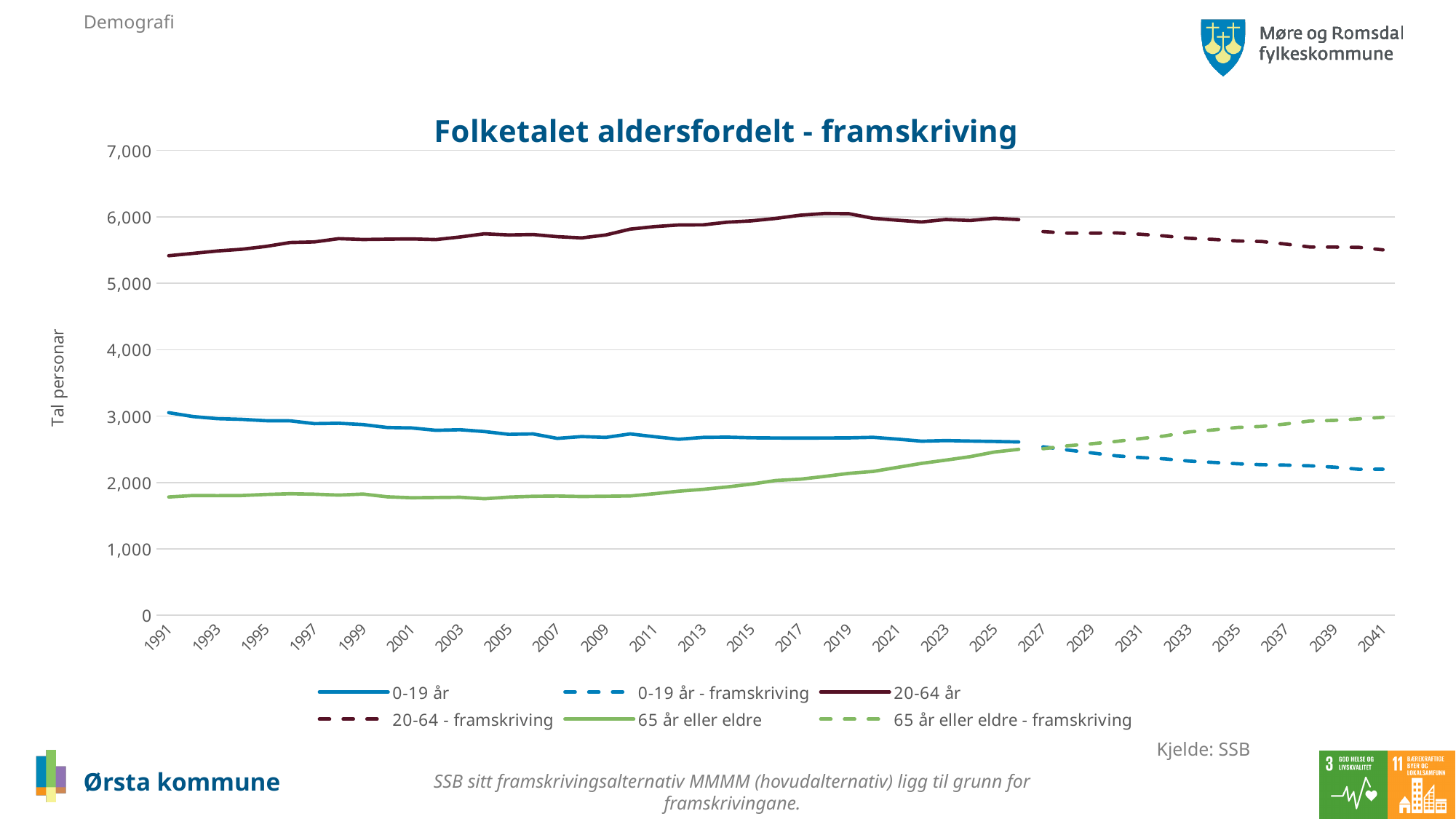
Is the value for 65 år eller eldre in 1991 greater or less than 2,000? less Is the value for 65 år eller eldre - framskriving in 2041 greater or less than 2,500? greater Does the 65 år eller eldre series rise or fall from 2009 to 2025? rise In 2041, which is higher: 0-19 år - framskriving or 65 år eller eldre - framskriving? 65 år eller eldre - framskriving Is the value for 20-64 år in 1991 greater or less than 5,000? greater How many series does the legend list? 6 What is the title of the chart? Folketalet aldersfordelt - framskriving What kind of chart is shown on the slide? line chart Does the 0-19 år series rise or fall from 1991 to 2025? fall Which series has the highest values across the whole chart? 20-64 år What source is cited below the chart? SSB